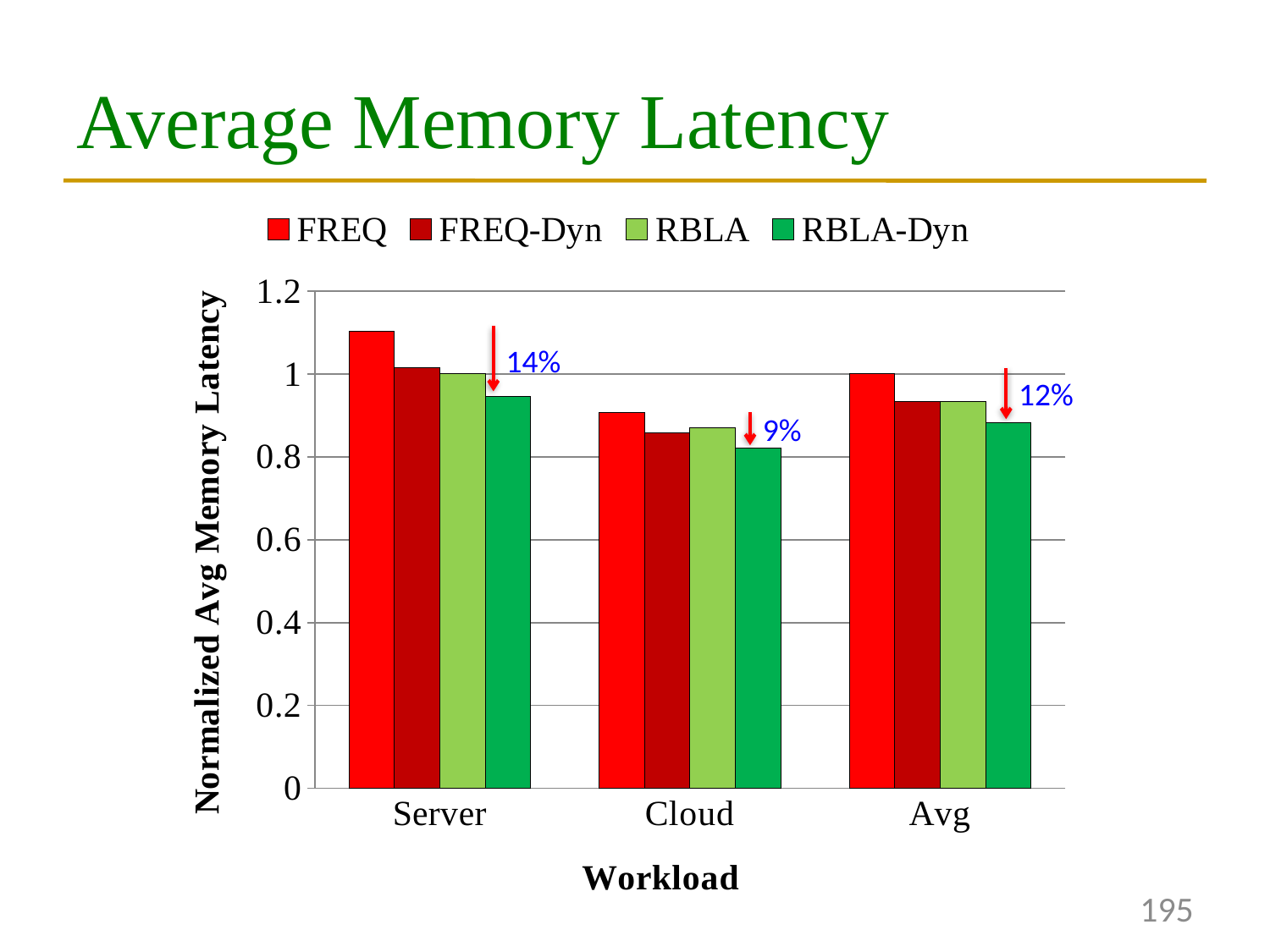
What percentage reduction is annotated above the RBLA-Dyn bar for the Server workload? 14% Which is larger, the FREQ value for Server or the FREQ value for Cloud? Server Which series has the lowest value for the Cloud workload? RBLA-Dyn What kind of chart is shown on the slide? bar chart How many series does the legend list? 4 What is the title of the slide's chart? Average Memory Latency How many workload categories are shown on the x axis? 3 Is the FREQ-Dyn value for Avg greater or less than 1? less Is the RBLA-Dyn value for Cloud greater or less than 0.9? less Which series has the highest value for the Server workload? FREQ Is the FREQ value for Server greater or less than 1? greater